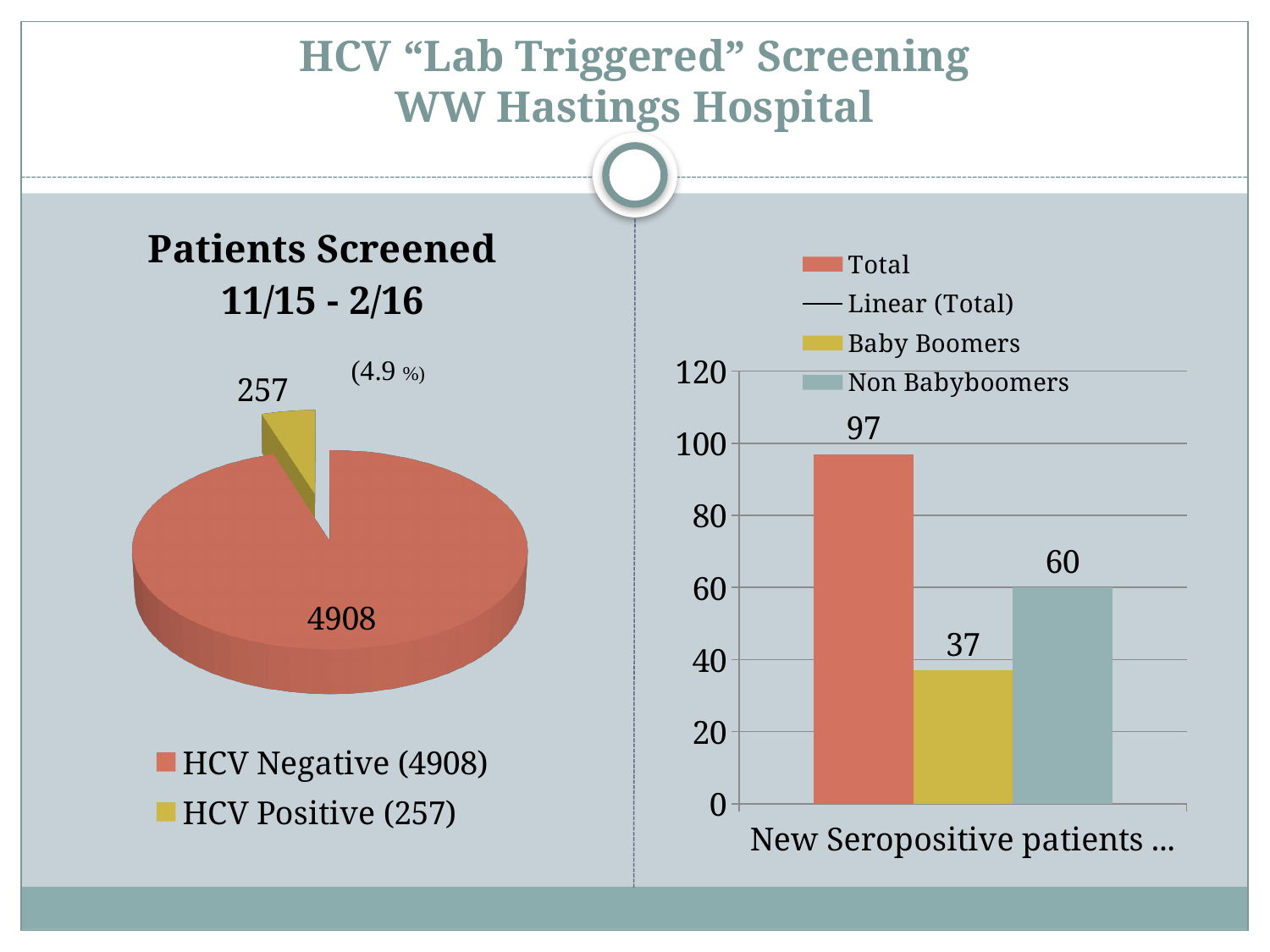
In the bar chart on the right, how many entries does the legend list? 4 In the bar chart on the right, what is the difference between the Non Babyboomers value and the Baby Boomers value? 23 In the 'Patients Screened 11/15 - 2/16' pie chart, what is the value for HCV Positive? 257 In the 'Patients Screened 11/15 - 2/16' pie chart, which category is the largest? HCV Negative In the bar chart on the right, what is the value for Non Babyboomers? 60 In the bar chart on the right, what is the value for Total? 97 In the 'Patients Screened 11/15 - 2/16' pie chart, what percentage share is printed for the HCV Positive slice? 4.9 % What kind of chart is the chart on the left side of the slide? Pie chart In the 'Patients Screened 11/15 - 2/16' pie chart, what is the value for HCV Negative? 4908 In the 'Patients Screened 11/15 - 2/16' pie chart, how many slices are there? 2 In the bar chart on the right, what is the value for Baby Boomers? 37 In the bar chart on the right, which is larger, Baby Boomers or Non Babyboomers? Non Babyboomers